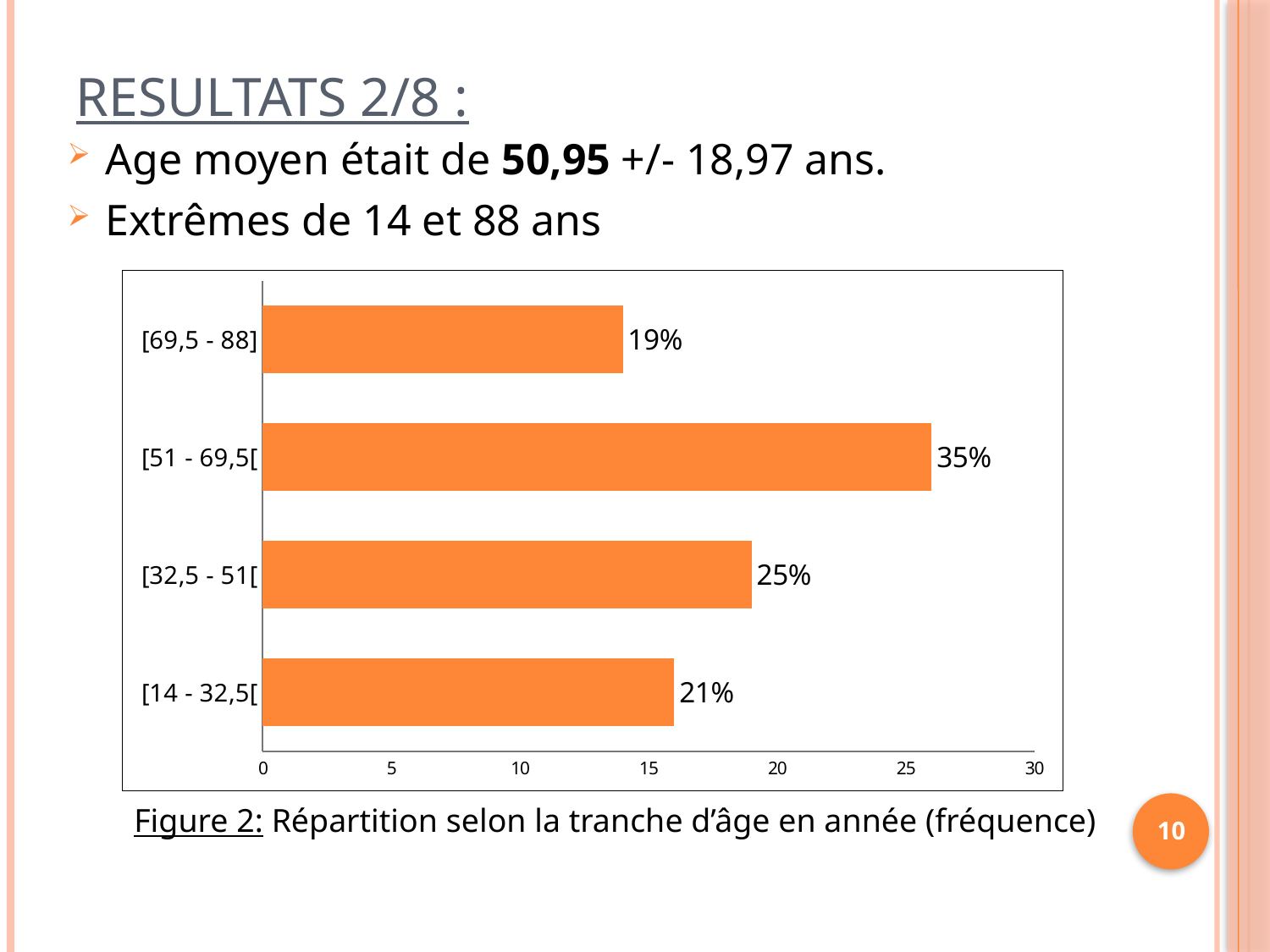
What kind of chart is shown on the slide? Bar chart What percentage is shown for the age group [14 - 32,5[? 21% What is the difference in percentage between the [51 - 69,5[ group and the [69,5 - 88] group? 16% What percentage is shown for the age group [69,5 - 88]? 19% Which age group has the highest percentage? [51 - 69,5[ What is the caption of the figure below the chart? Figure 2: Répartition selon la tranche d'âge en année (fréquence) What percentage is shown for the age group [51 - 69,5[? 35% What percentage is shown for the age group [32,5 - 51[? 25% Which age group has a larger percentage, [32,5 - 51[ or [14 - 32,5[? [32,5 - 51[ What is the difference in percentage between the [32,5 - 51[ group and the [14 - 32,5[ group? 4% How many age groups are shown in the chart? 4 Which age group has the lowest percentage? [69,5 - 88]